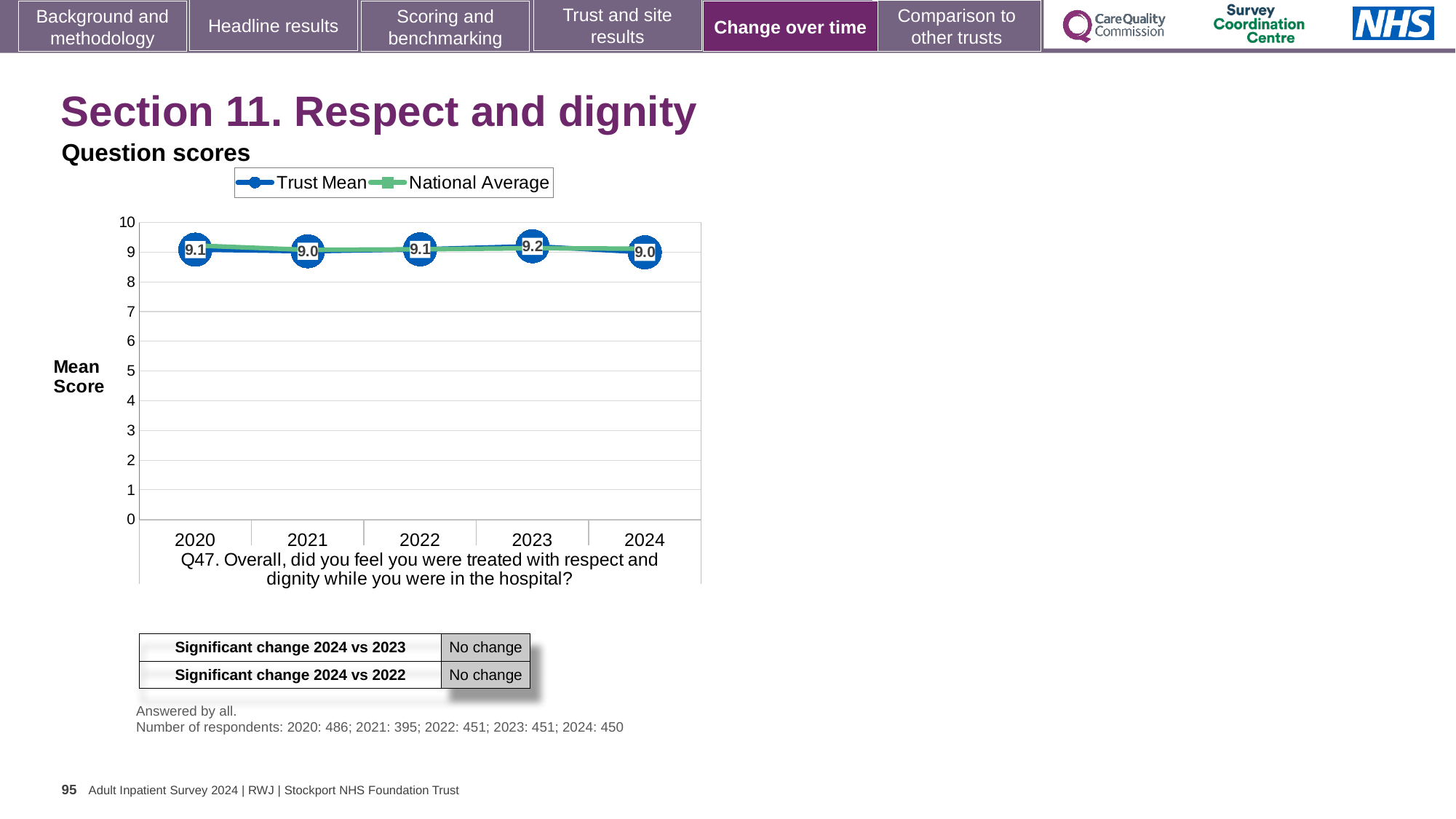
What is the Trust Mean score for 2021? 9.0 What is the difference between the Trust Mean scores for 2023 and 2024? 0.2 Does the Trust Mean score rise or fall from 2023 to 2024? Fall What is the Trust Mean score for 2020? 9.1 Is the National Average value for 2022 greater or less than 8? greater How many series does the chart legend list? 2 How many years are plotted on the x axis of the chart? 5 In which year is the Trust Mean score highest? 2023 What kind of chart is shown on the slide? Line chart What is the Trust Mean score for 2024? 9.0 Which year has the larger Trust Mean score, 2021 or 2023? 2023 What is the Trust Mean score for 2023? 9.2